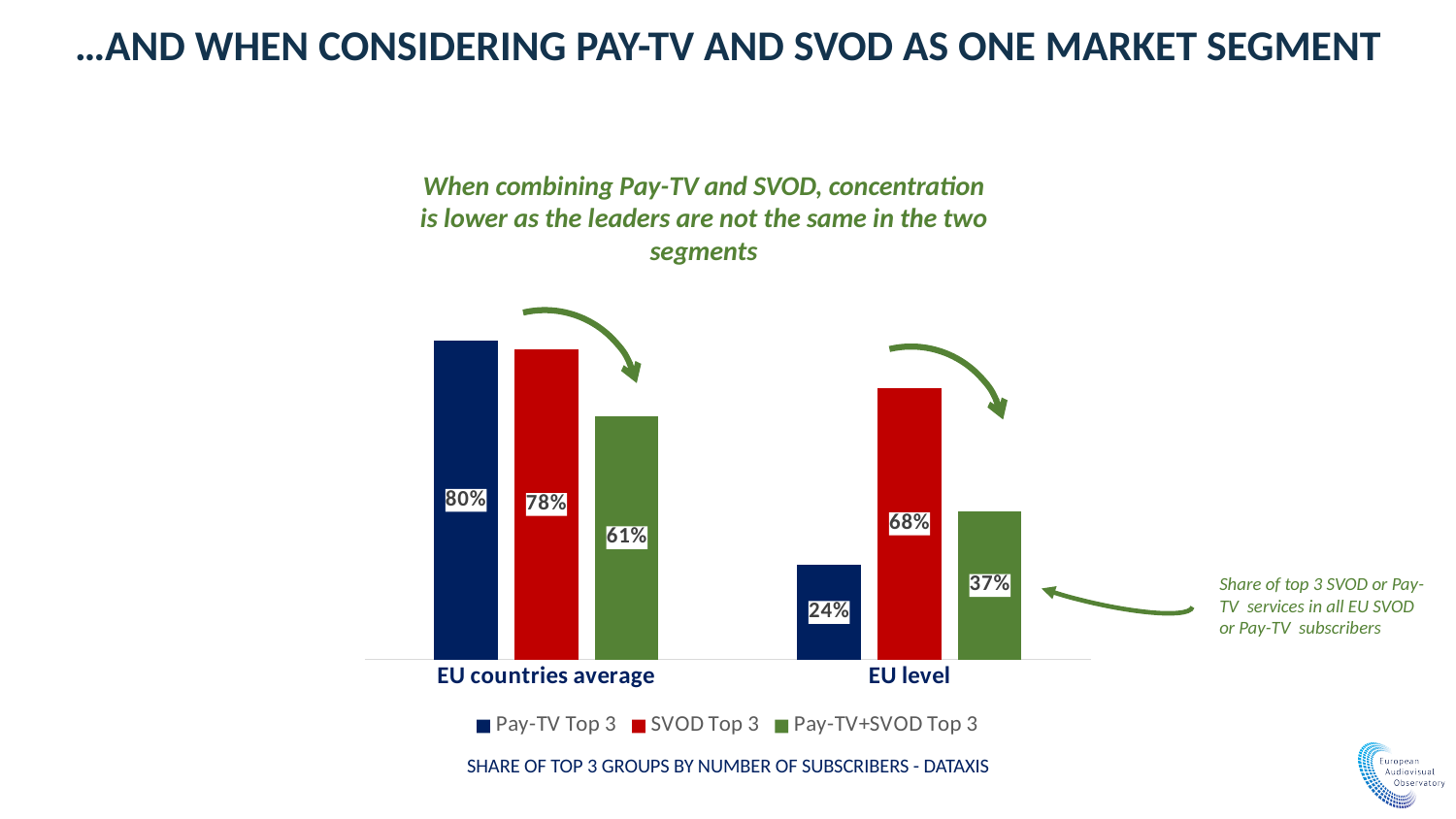
What colour are the Pay-TV+SVOD Top 3 bars? Green What is the value for SVOD Top 3 at EU level? 68% What is the value for Pay-TV+SVOD Top 3 in the EU countries average category? 61% Which series has the lowest value at EU level? Pay-TV Top 3 What is the value for Pay-TV Top 3 at EU level? 24% What is the value for Pay-TV Top 3 in the EU countries average category? 80% What is the difference between the SVOD Top 3 value and the Pay-TV+SVOD Top 3 value at EU level? 31% How many series does the legend list? 3 Which series has the highest value in the EU countries average category? Pay-TV Top 3 How many categories are shown on the x axis? 2 Which is larger: Pay-TV+SVOD Top 3 for EU countries average or Pay-TV+SVOD Top 3 at EU level? EU countries average What kind of chart is shown on the slide? Bar chart